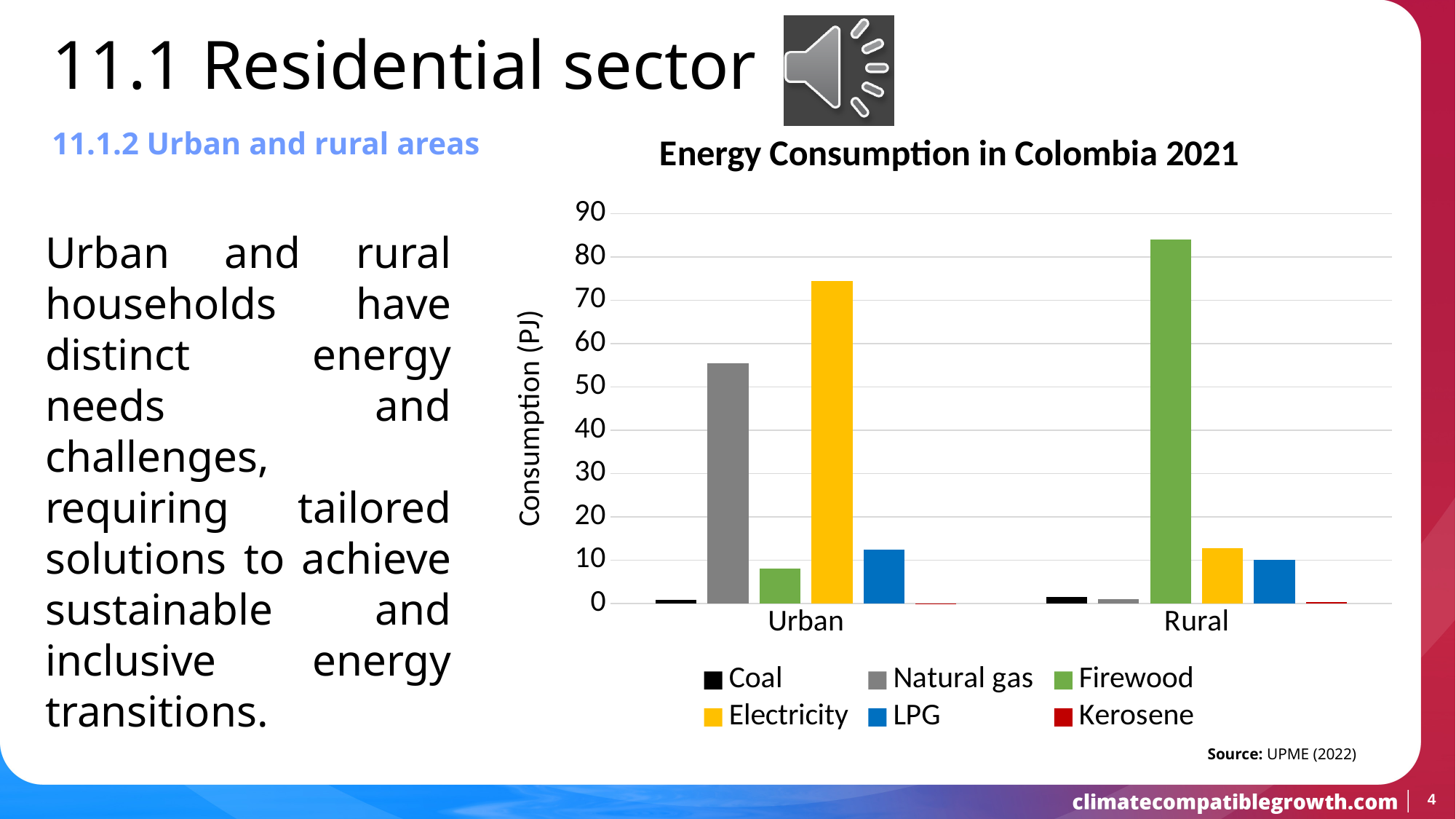
What is the label of the y axis of the chart? Consumption (PJ) Which is larger: Firewood consumption in Urban areas or Firewood consumption in Rural areas? Rural Is the value for Electricity in the Urban category greater or less than 70? greater Which energy source has the highest consumption in the Rural category? Firewood How many series does the legend of the Energy Consumption in Colombia 2021 chart list? 6 What kind of chart is shown on the slide? bar chart How many categories are shown on the x axis of the chart? 2 Is the value for Firewood in the Rural category greater or less than 80? greater Which is larger: Natural gas consumption in Urban areas or Natural gas consumption in Rural areas? Urban Is the value for Electricity in the Rural category greater or less than 20? less Which energy source has the highest consumption in the Urban category? Electricity